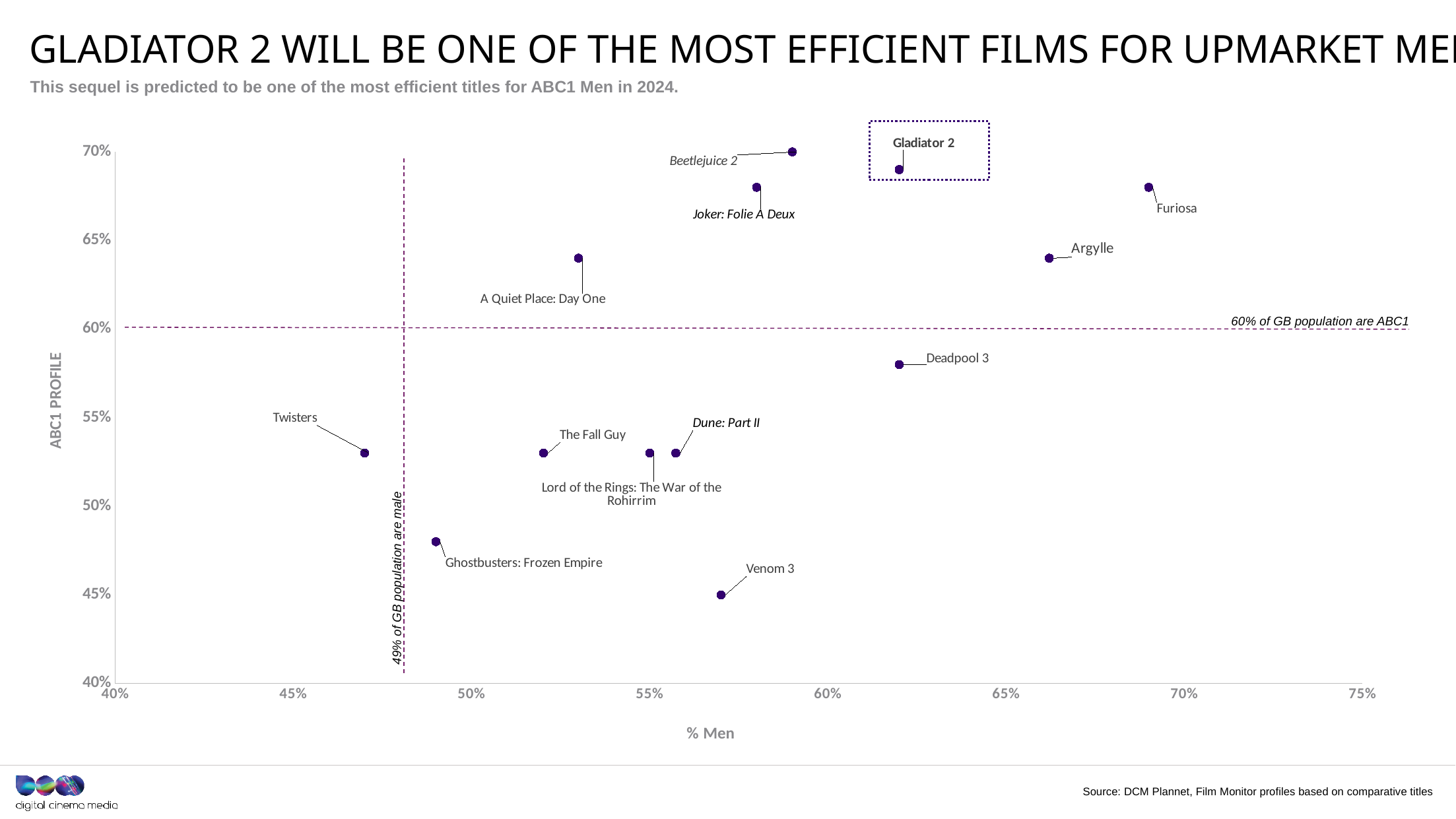
Is the ABC1 profile for Ghostbusters: Frozen Empire greater or less than 50%? less Which film has a higher ABC1 profile, Deadpool 3 or Venom 3? Deadpool 3 Which film has the highest ABC1 profile on the chart? Beetlejuice 2 What is the label of the horizontal axis of the chart? % Men Which film has the lowest % Men on the chart? Twisters What kind of chart is shown on the slide? scatter chart How many films are plotted on the chart? 13 Is the % Men for Gladiator 2 greater or less than 60%? greater Which film has a higher % Men, Argylle or A Quiet Place: Day One? Argylle Which film has the lowest ABC1 profile on the chart? Venom 3 Is the ABC1 profile for Deadpool 3 greater or less than 60%? less Which film has the highest % Men on the chart? Furiosa